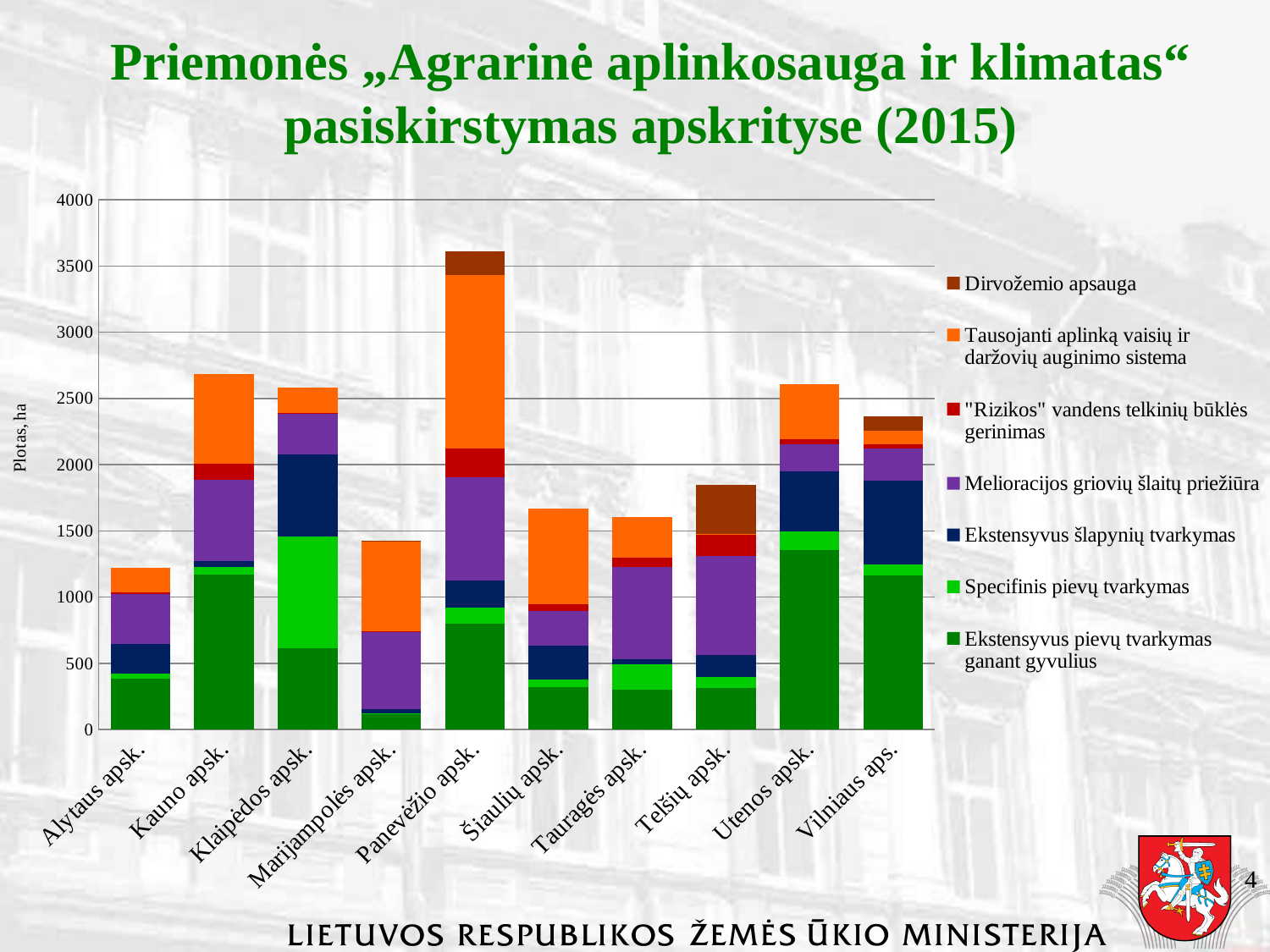
Which county has the shortest stacked bar? Alytaus apsk. What kind of chart is shown on the slide? Stacked bar chart How many series does the legend list? 7 Is the total value for Telšių apsk. greater or less than 2000? less Is the total value for Alytaus apsk. greater or less than 1500? less Which series is shown in dark green at the bottom of each bar? Ekstensyvus pievų tvarkymas ganant gyvulius Which county has the tallest stacked bar? Panevėžio apsk. Which has the larger total bar, Utenos apsk. or Telšių apsk.? Utenos apsk. Is the total value for Kauno apsk. greater or less than 2500? greater What is the label of the vertical axis? Plotas, ha How many counties (categories) are shown on the x axis? 10